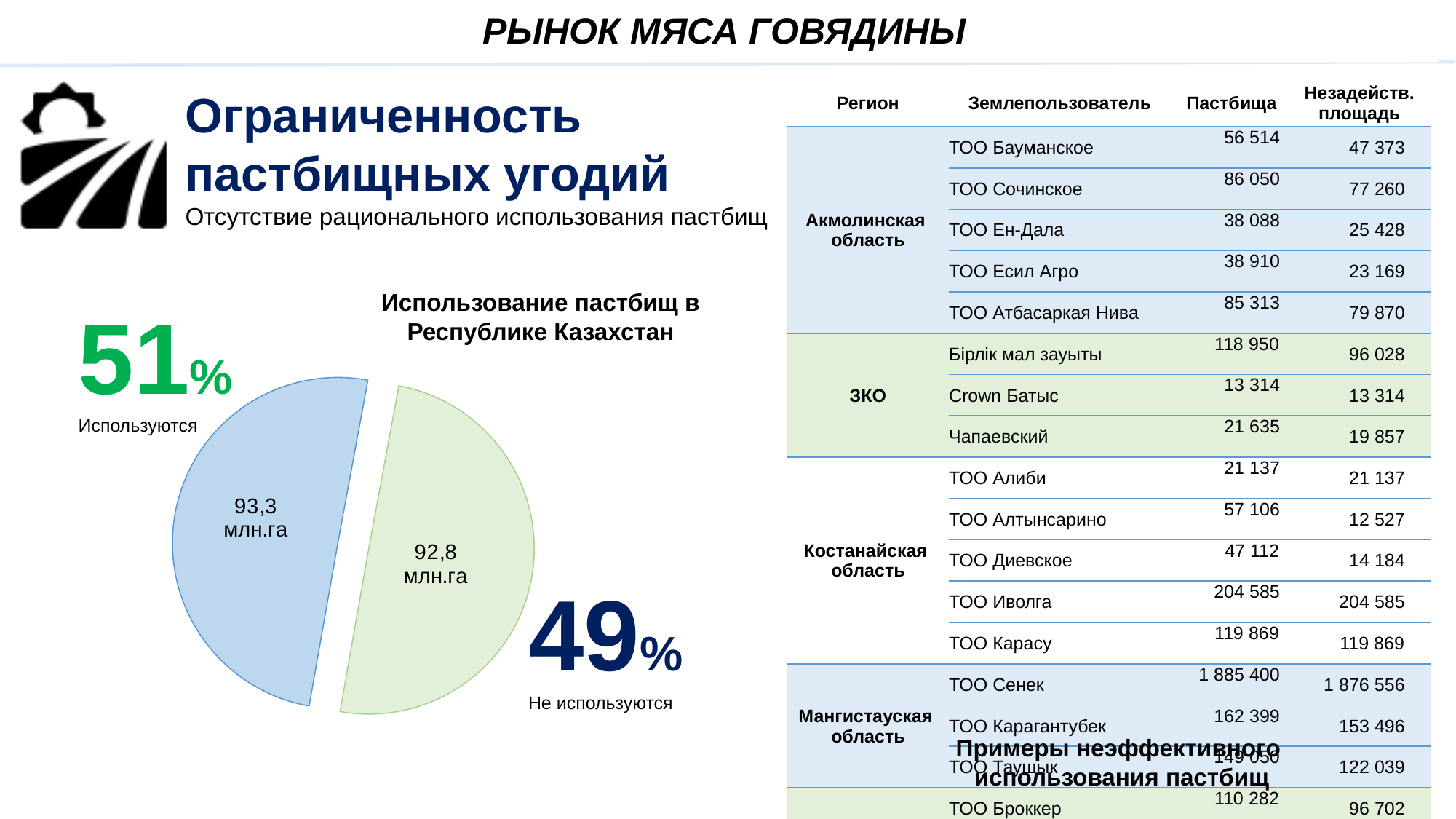
What colour is the "Не используются" slice of the pie chart? green How many slices does the pie chart have? 2 What is the total of the two slices in the pie chart in млн.га? 186,1 млн.га What value is shown for the slice labelled "Не используются"? 92,8 млн.га What share of the pie does the "Используются" slice represent? 51% What share of the pie does the "Не используются" slice represent? 49% What value is shown for the slice labelled "Используются"? 93,3 млн.га Which slice of the pie chart is the smallest? Не используются What is the title of the pie chart? Использование пастбищ в Республике Казахстан Which slice of the pie chart is larger, "Используются" or "Не используются"? Используются What is the difference in млн.га between the "Используются" and "Не используются" slices? 0,5 млн.га What kind of chart is shown on the slide? pie chart